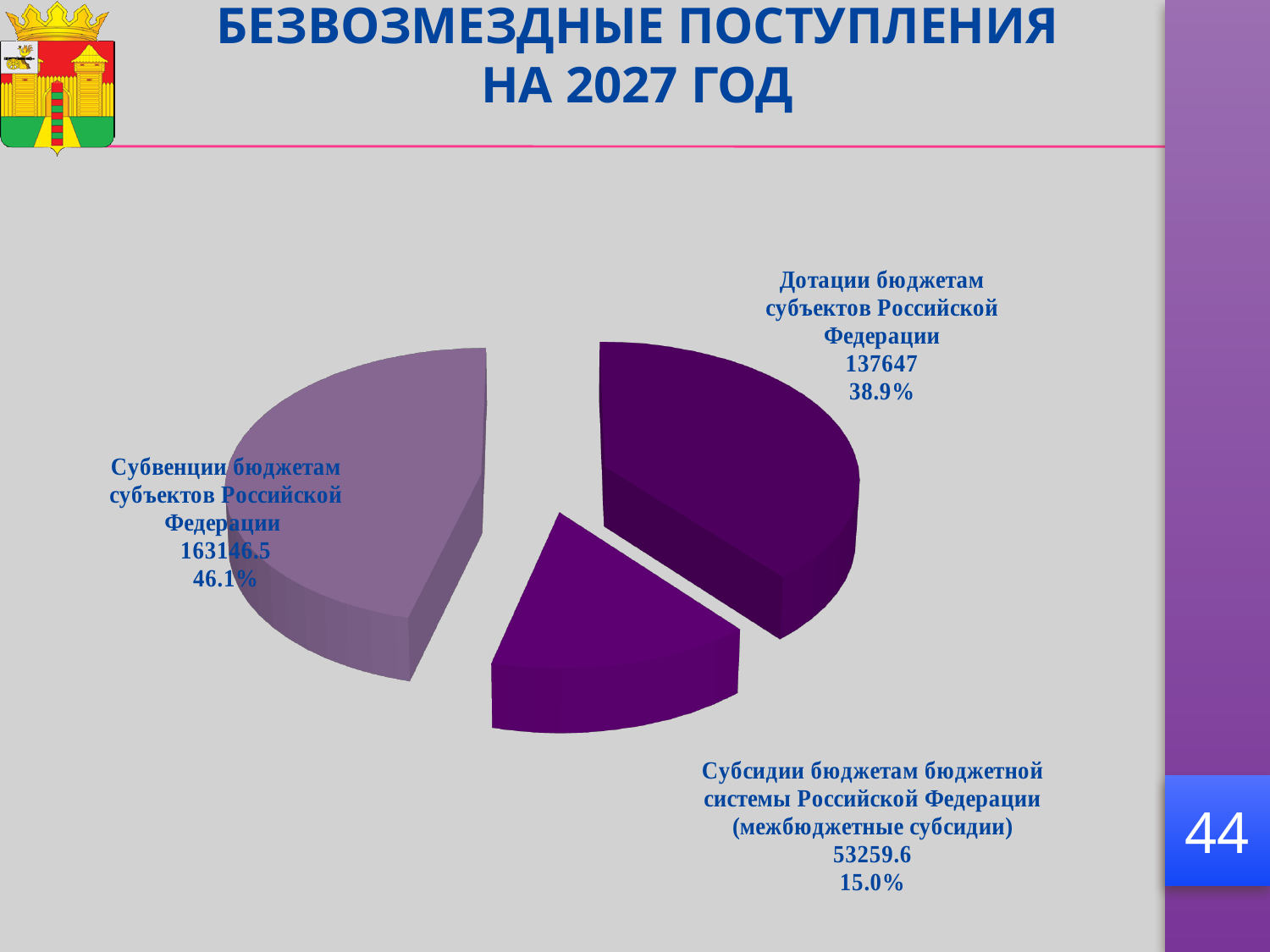
What type of chart is shown on the slide? Pie chart Which is larger: Дотации бюджетам субъектов Российской Федерации or Субсидии бюджетам бюджетной системы Российской Федерации (межбюджетные субсидии)? Дотации бюджетам субъектов Российской Федерации What is the difference between the values for Субвенции бюджетам субъектов Российской Федерации and Дотации бюджетам субъектов Российской Федерации? 25499.5 What share of the pie does Дотации бюджетам субъектов Российской Федерации represent? 38.9% What is the value for Дотации бюджетам субъектов Российской Федерации? 137647 What is the title of the slide containing the pie chart? БЕЗВОЗМЕЗДНЫЕ ПОСТУПЛЕНИЯ НА 2027 ГОД What is the value for Субвенции бюджетам субъектов Российской Федерации? 163146.5 Which category has the largest value? Субвенции бюджетам субъектов Российской Федерации What share of the pie does Субсидии бюджетам бюджетной системы Российской Федерации (межбюджетные субсидии) represent? 15.0% Which category has the smallest value? Субсидии бюджетам бюджетной системы Российской Федерации (межбюджетные субсидии) How many slices does the pie chart have? 3 What is the value for Субсидии бюджетам бюджетной системы Российской Федерации (межбюджетные субсидии)? 53259.6